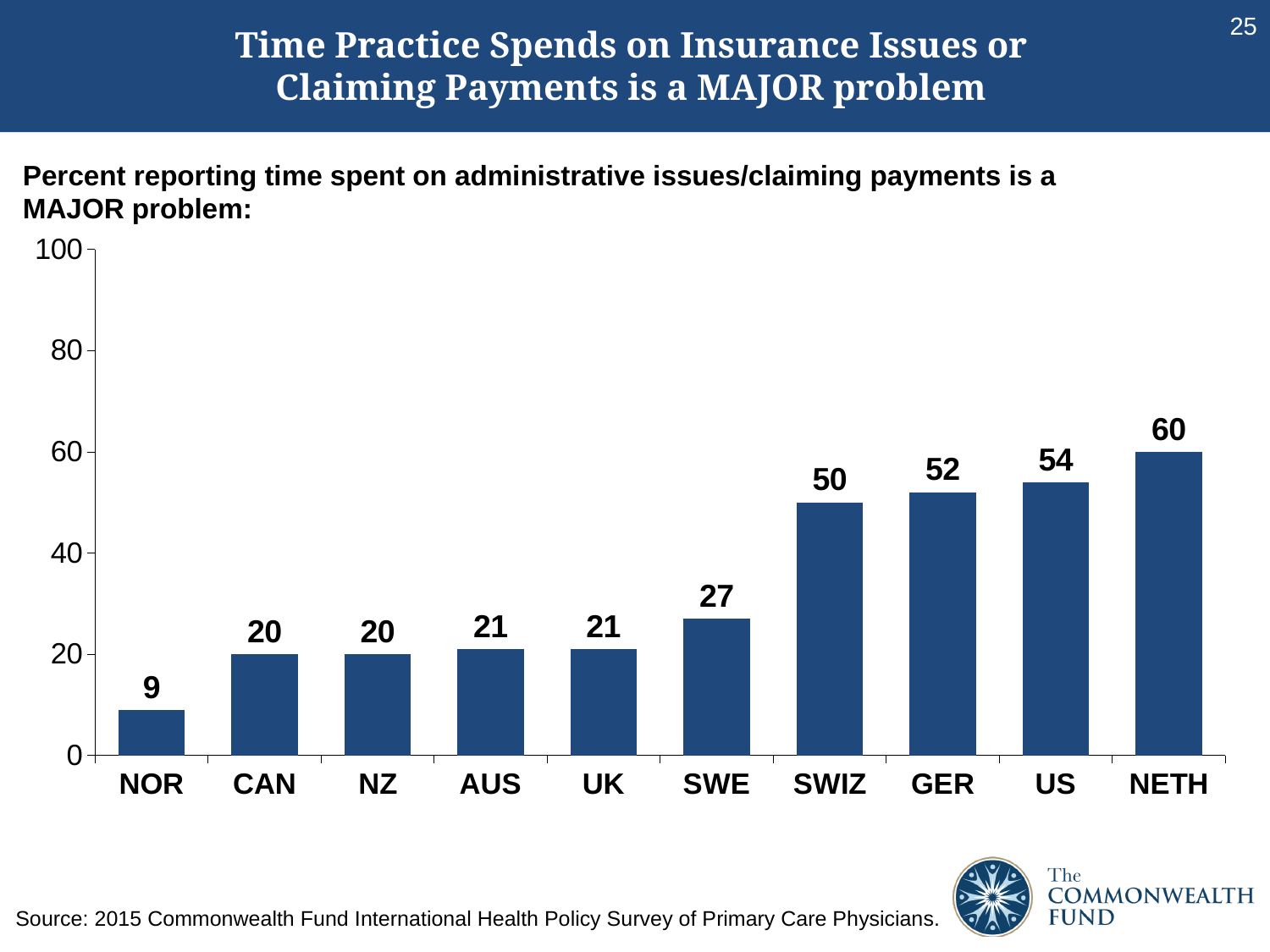
What is the value for SWE? 27 Is the value for SWIZ greater or less than 40? greater What kind of chart is shown on the slide? bar chart How many countries are shown on the chart? 10 What is the value for the US? 54 Do the values generally rise or fall from left to right along the x axis? rise Which country has the lowest value? NOR What is the value for NOR? 9 What is the difference between the values for GER and SWIZ? 2 Which country has the highest value? NETH Which is larger, the value for SWE or the value for UK? SWE What is the difference between the values for NETH and NOR? 51